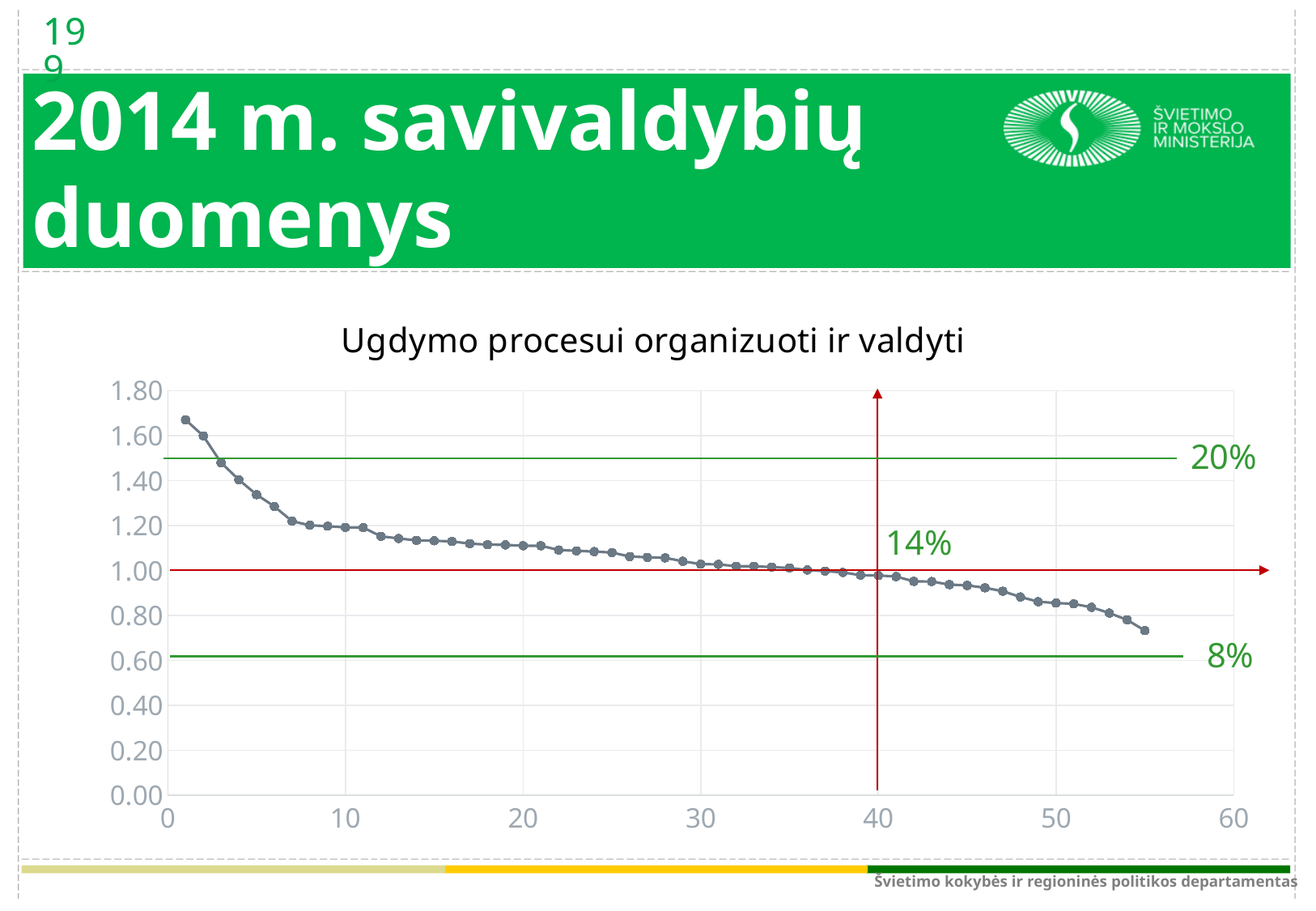
Is the value of the first plotted point (at x = 1) greater or less than 1.60? greater Which is larger, the value at x = 5 or the value at x = 45? x = 5 What kind of chart is shown on the slide? line chart Do the plotted values rise or fall as the x axis increases? fall What percentage label is written next to the upper green horizontal line? 20% What is the highest value shown on the y axis? 1.80 Is the value of the point at x = 20 greater or less than 1.20? less What is the title of the chart? Ugdymo procesui organizuoti ir valdyti Is the value of the last plotted point (at x = 55) greater or less than 0.80? less